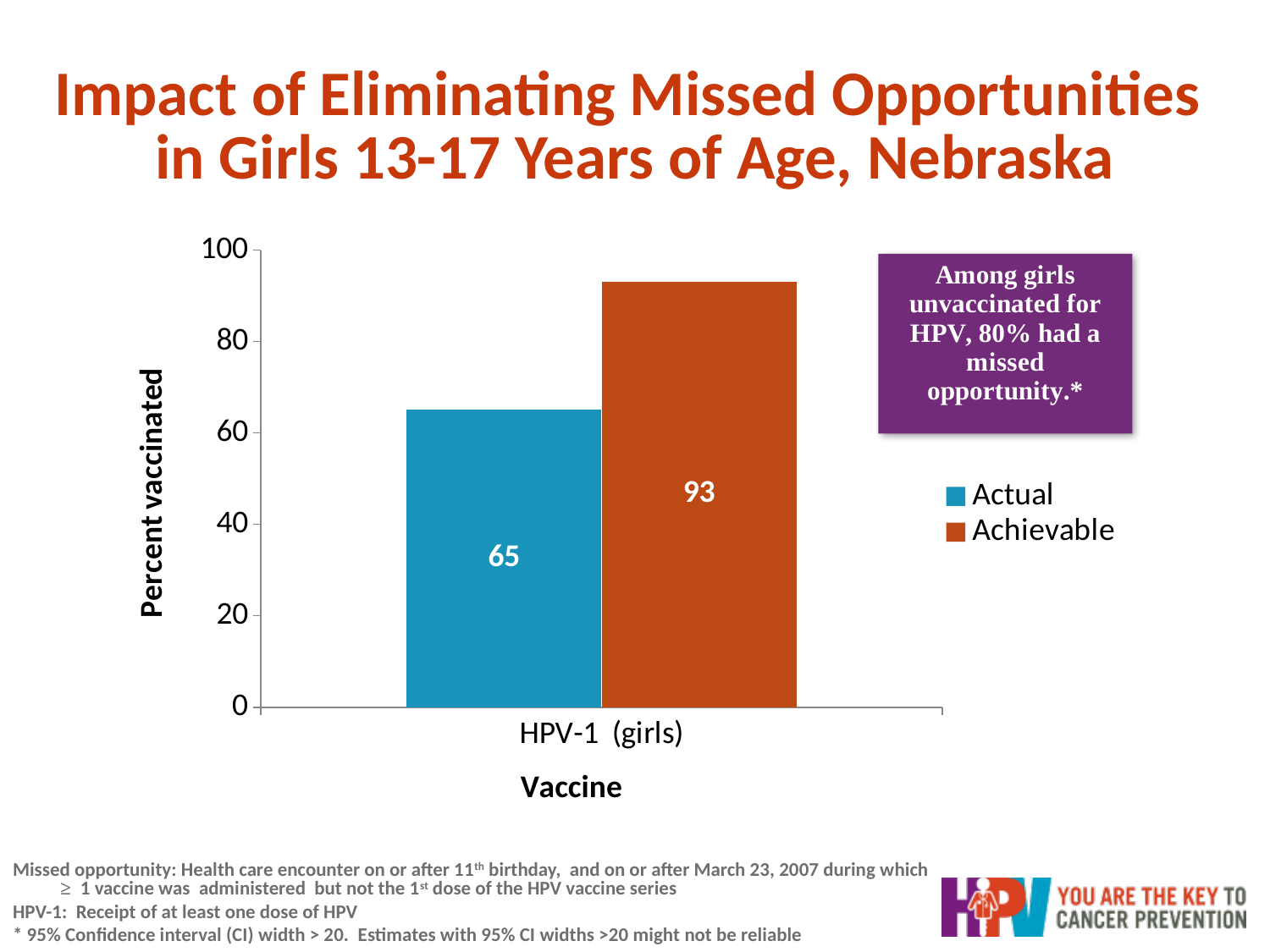
Which series has the lowest value in the chart? Actual Which series has the higher value for HPV-1 (girls), Actual or Achievable? Achievable What is the label of the y axis? Percent vaccinated What is the difference between the Achievable and Actual values for HPV-1 (girls)? 28 What kind of chart is shown on the slide? Bar chart Is the Achievable value for HPV-1 (girls) greater or less than 80? greater What is the Achievable percent vaccinated for HPV-1 (girls)? 93 Which series is shown in blue in the legend? Actual How many categories are shown on the x axis? 1 Is the Actual value for HPV-1 (girls) greater or less than 60? greater How many series does the legend list? 2 What is the Actual percent vaccinated for HPV-1 (girls)? 65